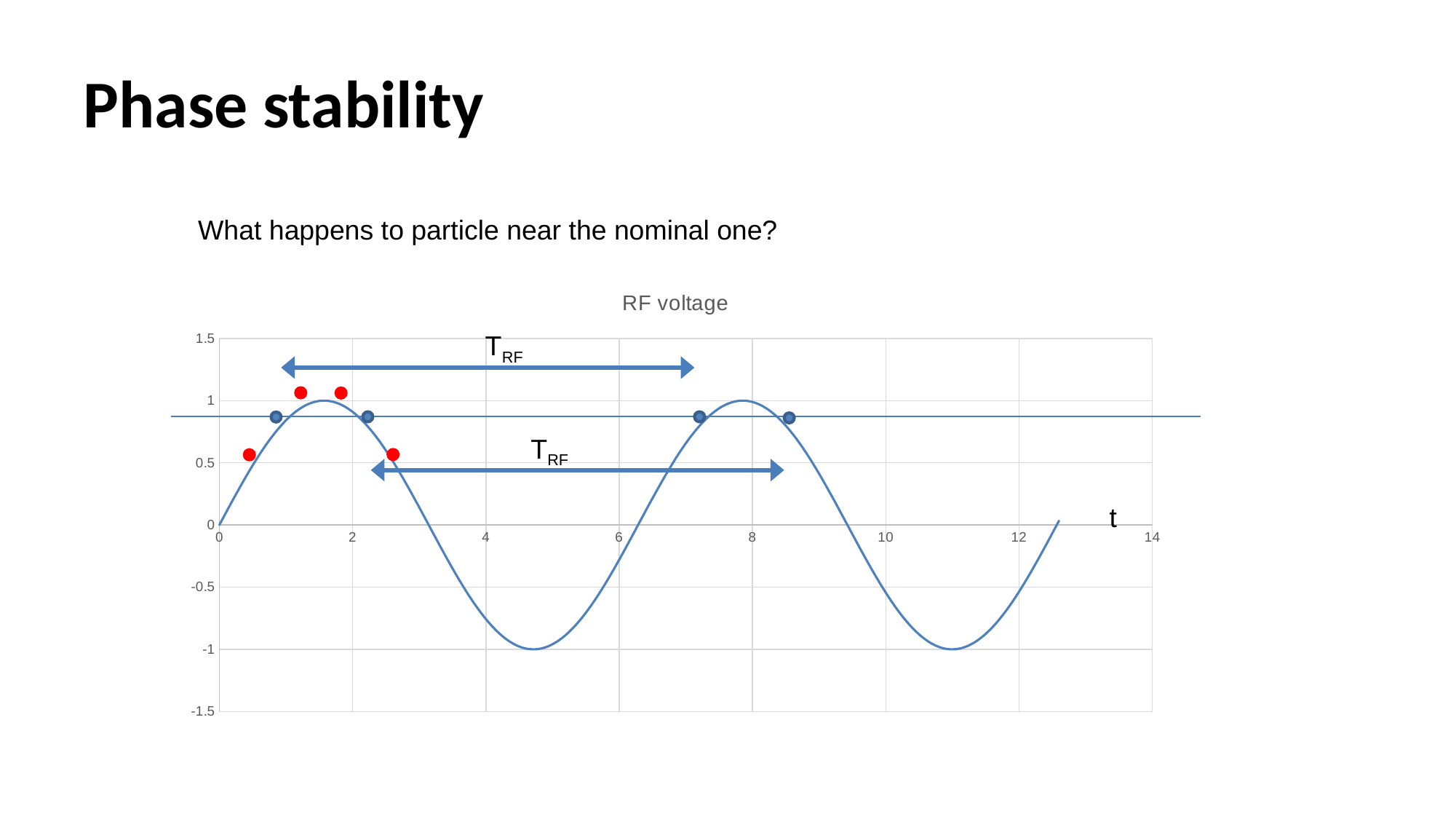
What is the title of the chart? RF voltage Is the value of the RF voltage curve at t = 2 greater or less than 0.5? greater What label is shown on the horizontal axis of the chart? t What is the minimum value reached by the RF voltage curve? -1 Is the value of the RF voltage curve at t = 4 greater or less than -0.5? less What is the value of the RF voltage curve at t = 0? 0 What kind of chart is shown on the slide? line chart What is the maximum value reached by the RF voltage curve? 1 Does the RF voltage curve rise or fall between t = 2 and t = 4? fall Is the value of the RF voltage curve at t = 8 greater or less than 0.5? greater Which is larger, the RF voltage at t = 2 or at t = 4? t = 2 How many red dots are plotted on the chart? 4